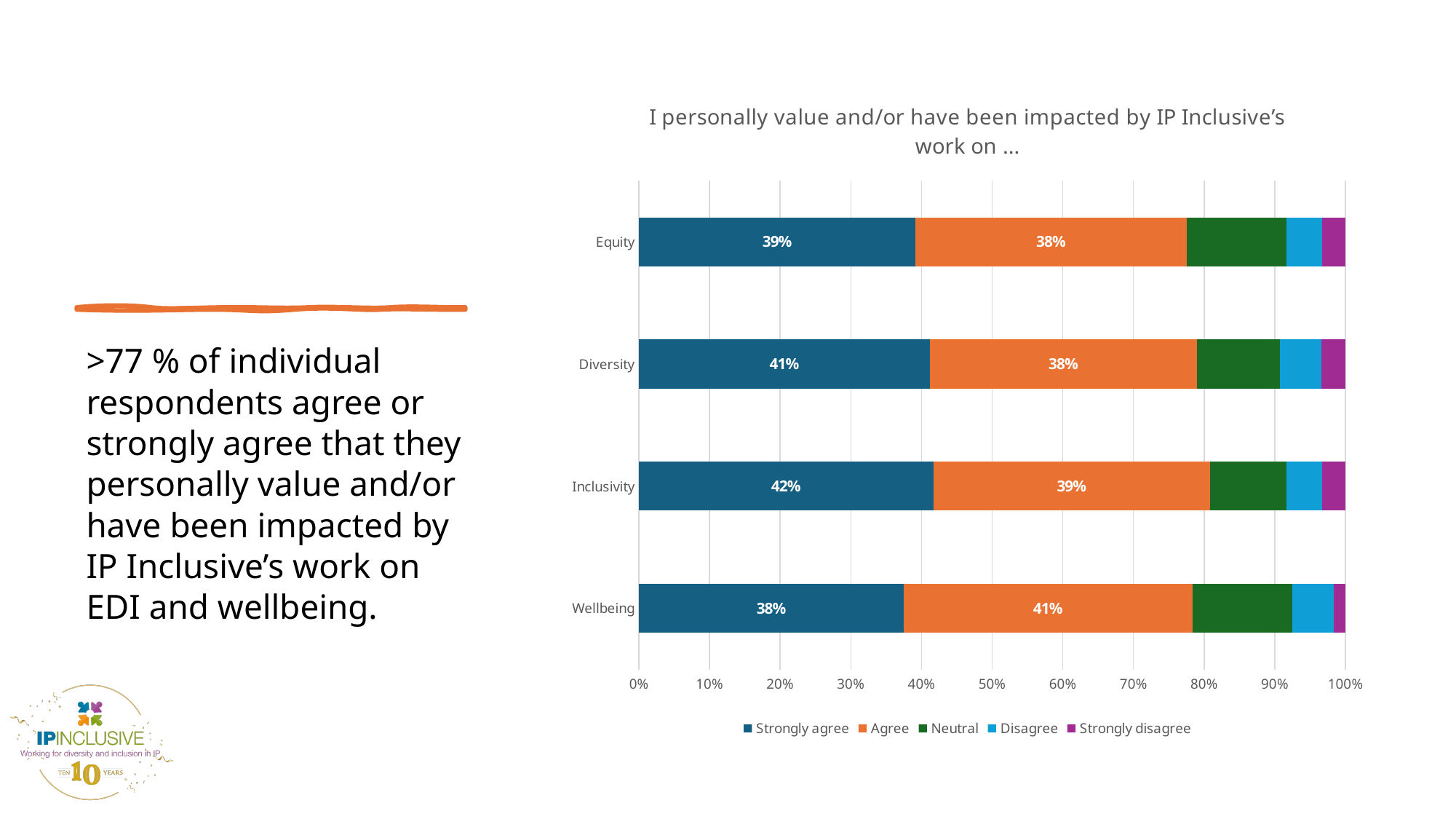
How many categories are shown on the chart? 4 Which category has the lowest Strongly agree percentage? Wellbeing What is the combined Strongly agree and Agree percentage for Inclusivity? 81% What is the Strongly agree value for Diversity? 41% Is the Disagree share for Equity greater or less than 10%? less What is the Agree value for Wellbeing? 41% What is the difference between the Strongly agree values for Inclusivity and Wellbeing? 4 percentage points Which category has the highest Strongly agree percentage? Inclusivity What kind of chart is shown on the slide? Stacked bar chart Which is larger: the Agree value for Wellbeing or the Agree value for Equity? Wellbeing How many series does the legend list? 5 What percentage of respondents strongly agree for Equity? 39%